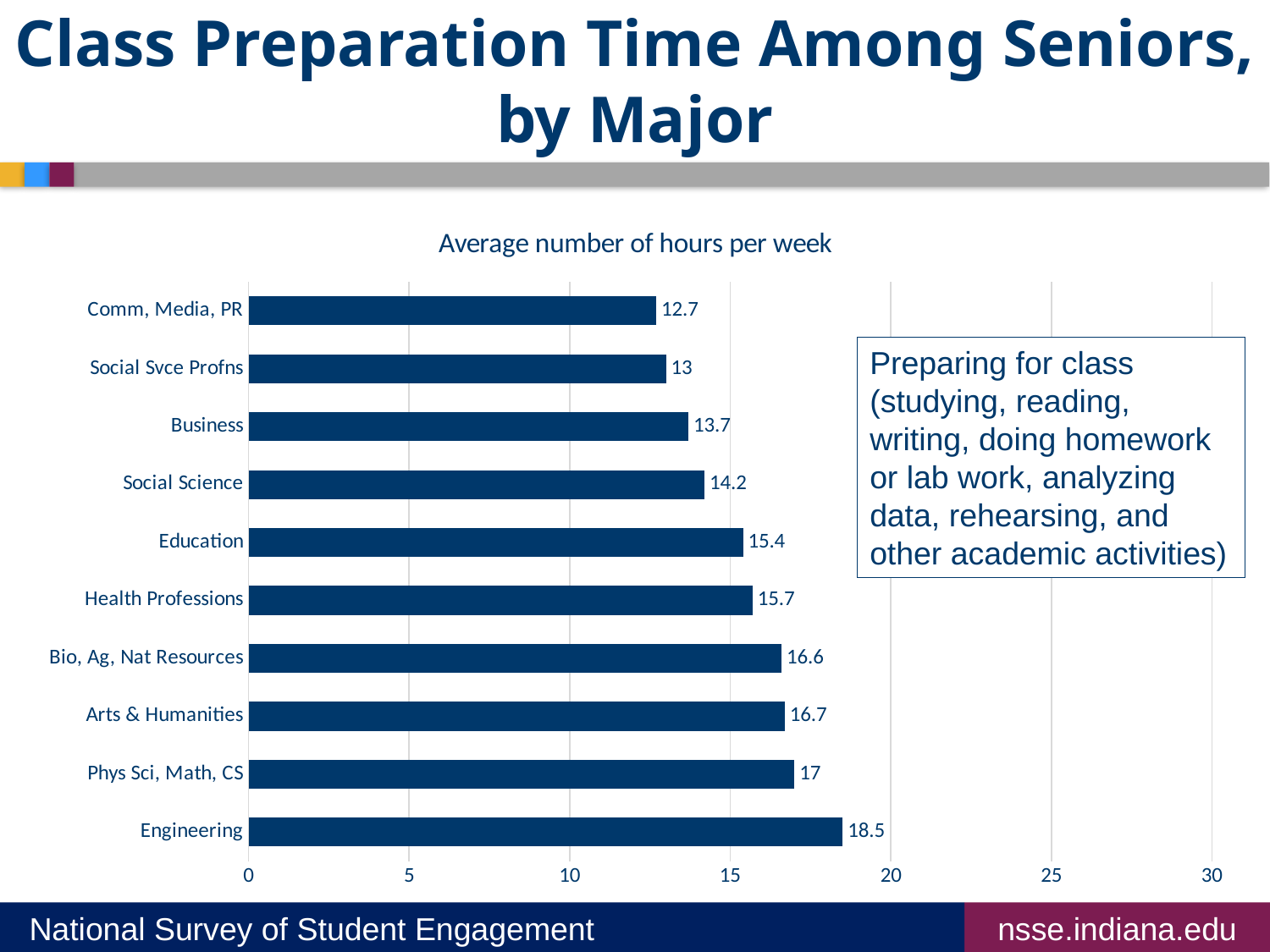
What is the difference between Education and Social Science? 1.2 What is the average number of hours per week for Business? 13.7 What is the value for Health Professions? 15.7 Is the value for Bio, Ag, Nat Resources greater or less than 15? greater What is the difference in hours per week between Engineering and Comm, Media, PR? 5.8 Which major has the lowest average number of hours per week? Comm, Media, PR What is the title shown above the chart? Average number of hours per week Which is larger, the value for Phys Sci, Math, CS or the value for Social Svce Profns? Phys Sci, Math, CS What is the average number of hours per week for Engineering? 18.5 Which major has the highest average number of hours per week? Engineering What kind of chart is shown on the slide? Bar chart How many majors are shown in the chart? 10